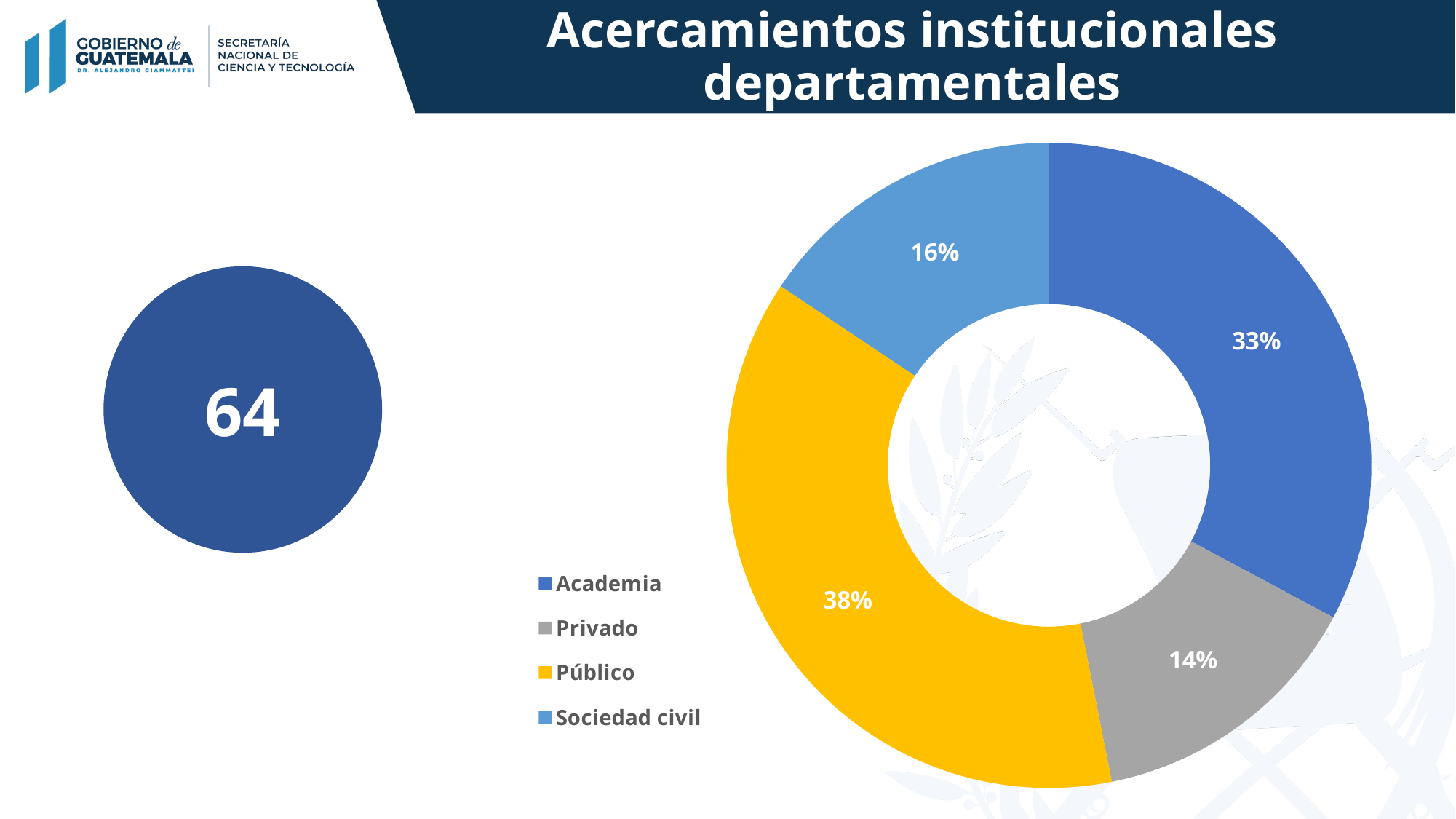
What number is shown in the large circle to the left of the chart? 64 What share of the chart does Privado represent? 14% What share of the chart does Academia represent? 33% What colour is the Público slice? Yellow Which has a larger share, Sociedad civil or Privado? Sociedad civil What kind of chart is shown on the slide? Pie chart (doughnut) Which category has the smallest share of the chart? Privado What share of the chart does Sociedad civil represent? 16% What is the difference in percentage points between Público and Academia? 5 What share of the chart does Público represent? 38% How many categories does the chart show? 4 Which category has the largest share of the chart? Público